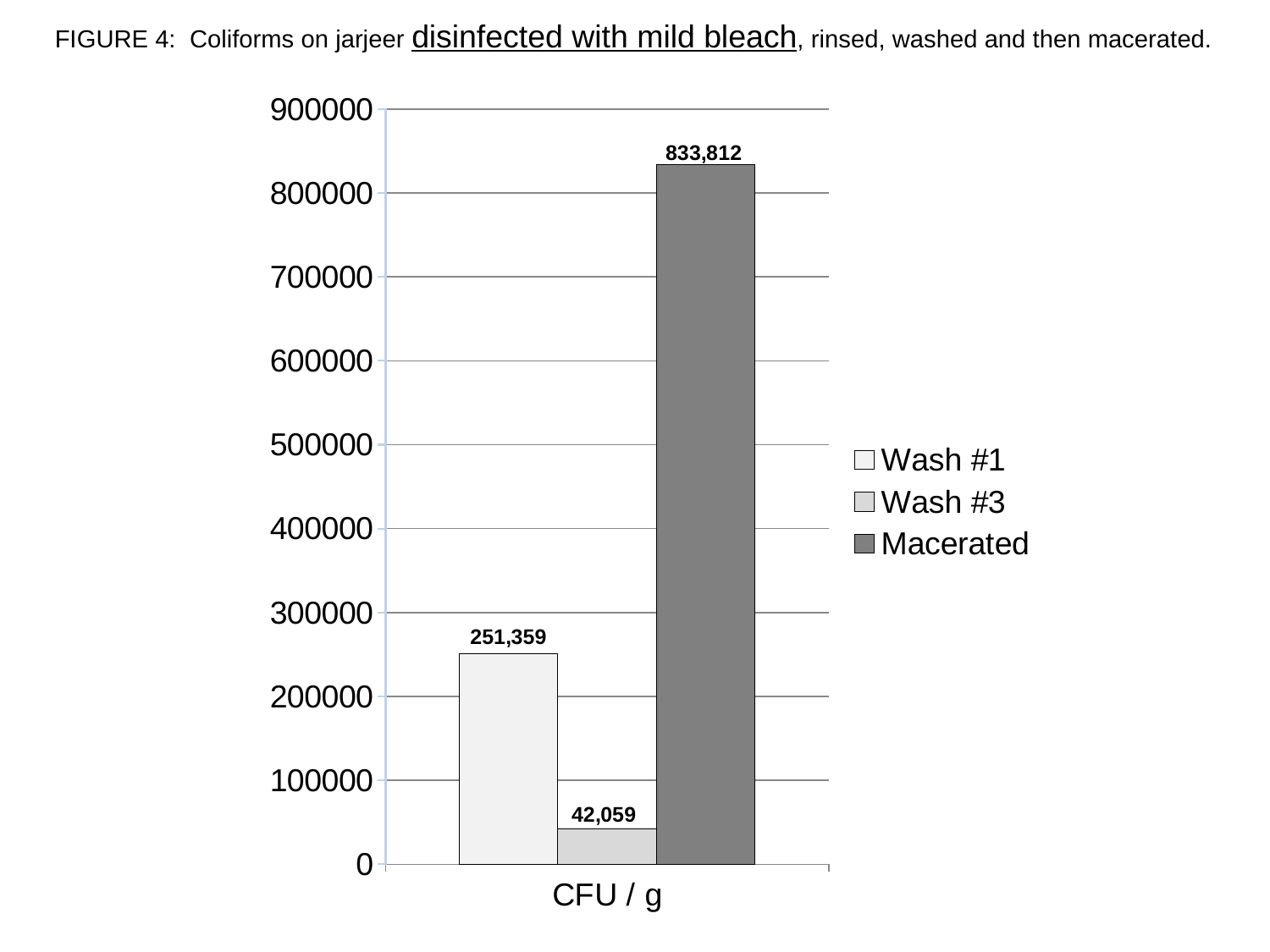
Which series has the lowest value? Wash #3 How many series does the legend list? 3 Which is larger, the value for Wash #1 or the value for Wash #3? Wash #1 Which series has the highest value? Macerated What is the difference between the Wash #1 value and the Wash #3 value? 209,300 What is the value for Wash #3? 42,059 Is the value for Macerated greater or less than 800000? greater What is the label shown on the x axis of the chart? CFU / g What kind of chart is shown on the slide? bar chart What is the value for Wash #1? 251,359 What is the difference between the Macerated value and the Wash #1 value? 582,453 What is the value for Macerated? 833,812